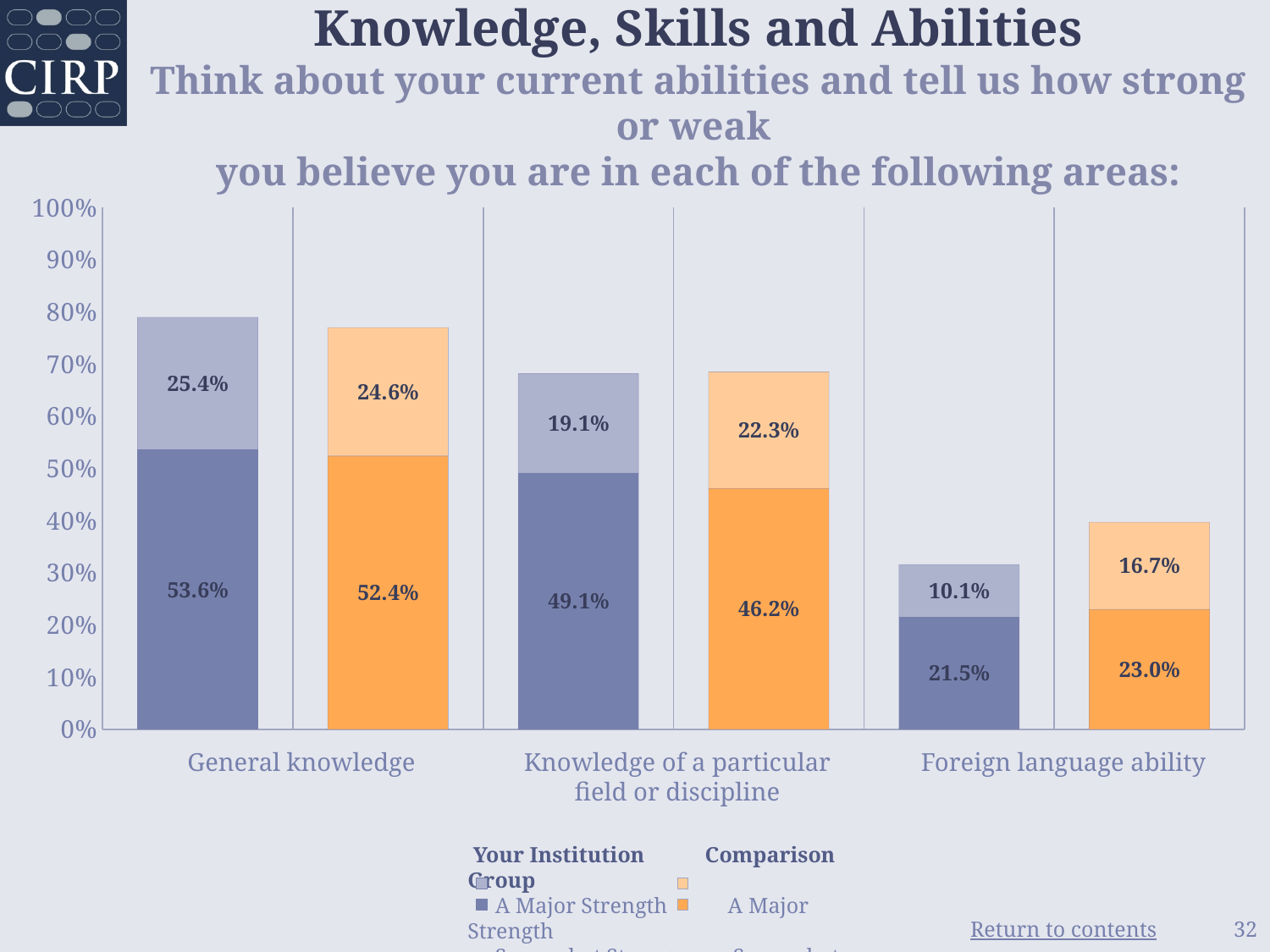
Which category has the lowest 'A Major Strength' value for Your Institution? Foreign language ability What percentage of Your Institution respondents rated General knowledge as 'A Major Strength'? 53.6% For Foreign language ability, which group has the larger 'A Major Strength' value, Your Institution or the Comparison Group? Comparison Group What kind of chart is shown on the slide? Stacked bar chart For Foreign language ability, what is the difference between the Comparison Group's top segment (16.7%) and Your Institution's top segment (10.1%)? 6.6 percentage points What is the total height of the Comparison Group stacked bar for Foreign language ability? 39.7% For General knowledge, how much higher is Your Institution's 'A Major Strength' value than the Comparison Group's? 1.2 percentage points What is the Comparison Group's 'A Major Strength' value for Foreign language ability? 23.0% How many ability categories are shown on the x axis? 3 What is the value of the lighter (top) segment of the Your Institution bar for Knowledge of a particular field or discipline? 19.1% What is the total height of the Your Institution stacked bar for General knowledge? 79.0% What is the value of the lighter (top) segment of the Comparison Group bar for Foreign language ability? 16.7%